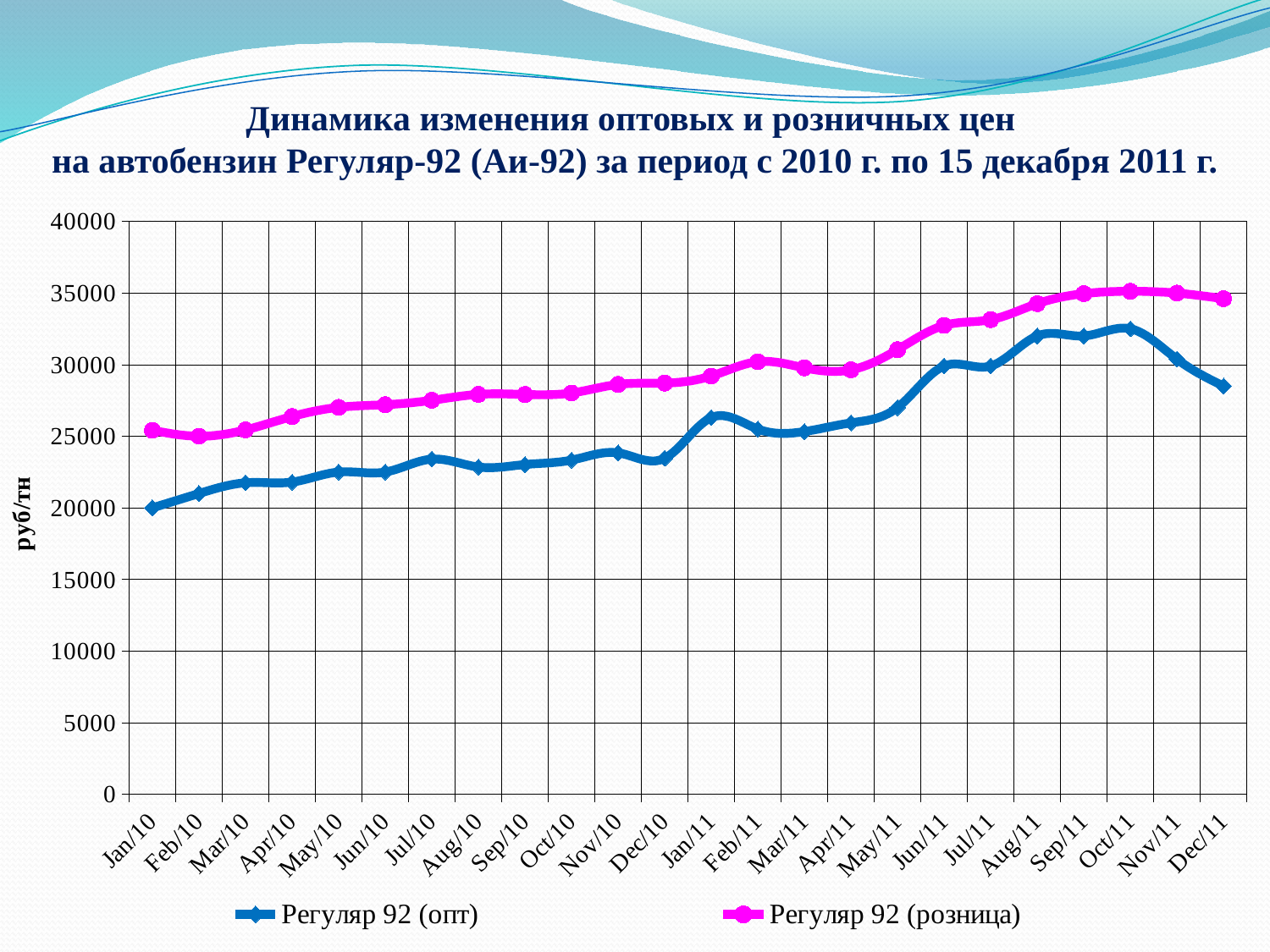
Is the value for Регуляр 92 (опт) in Jan/10 greater or less than 25000? less Is the value for Регуляр 92 (опт) in Jun/11 greater or less than 25000? greater Is the value for Регуляр 92 (розница) in Aug/11 greater or less than 30000? greater Does the Регуляр 92 (опт) series rise or fall from Oct/11 to Dec/11? fall In Dec/11, which series has the higher value, Регуляр 92 (опт) or Регуляр 92 (розница)? Регуляр 92 (розница) In which month is the Регуляр 92 (опт) series at its lowest? Jan/10 Does the Регуляр 92 (розница) series generally rise or fall from Jan/10 to Oct/11? rise How many series does the legend list? 2 What is the label on the vertical axis? руб/тн How many months (data points) are plotted along the x axis? 24 What kind of chart is shown on the slide? line chart